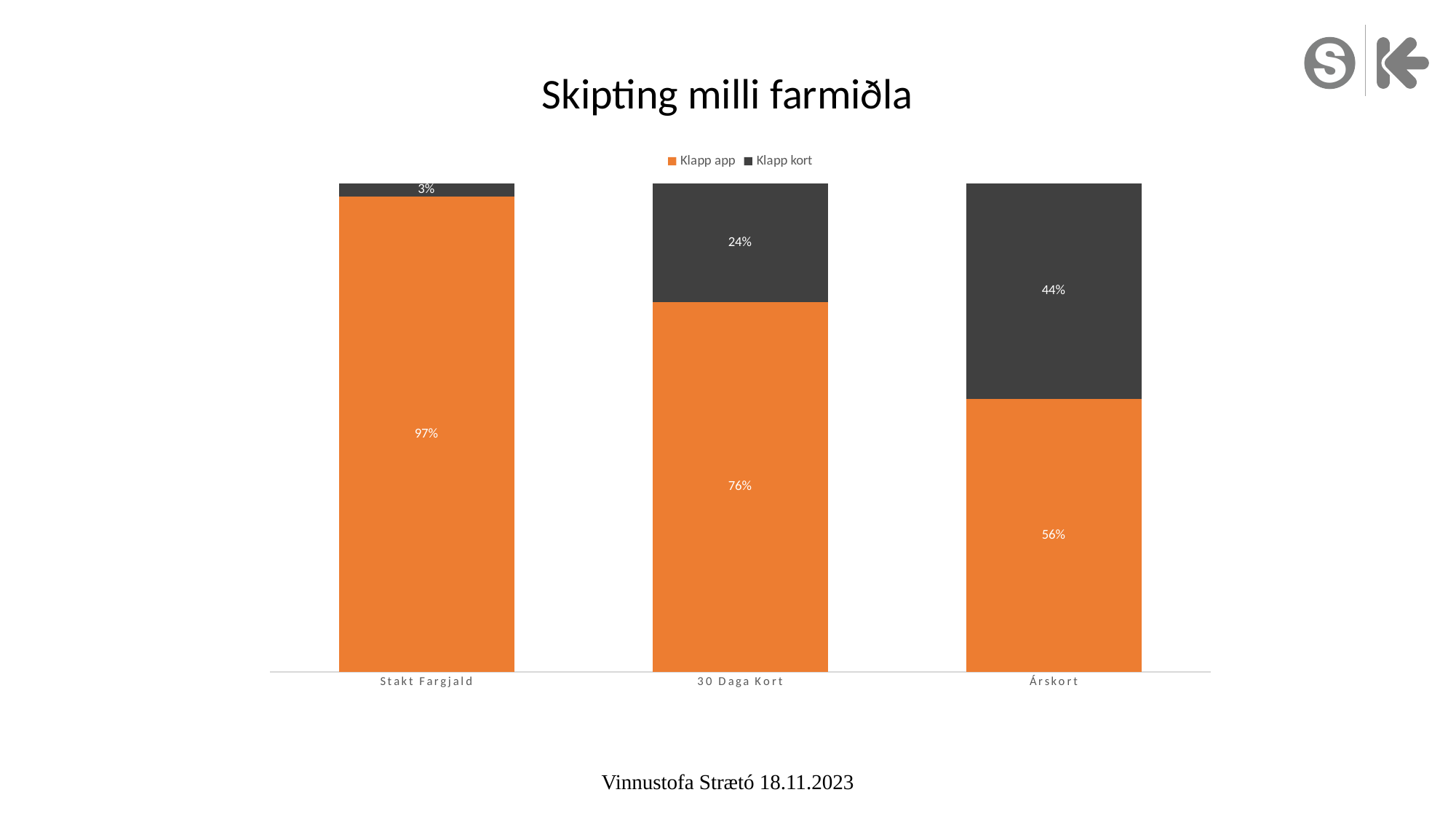
What is the difference between the Klapp app values for Stakt Fargjald and 30 Daga Kort? 21% How many categories are shown on the x axis? 3 What is the Klapp app value for Stakt Fargjald? 97% How many series does the legend list? 2 What is the title of the chart? Skipting milli farmiðla What kind of chart is shown? Stacked bar chart Which category has the highest Klapp kort share? Árskort Which is larger for Árskort, Klapp app or Klapp kort? Klapp app What is the Klapp kort value for 30 Daga Kort? 24% What is the Klapp app value for Árskort? 56% Which category has the lowest Klapp app share? Árskort What is the Klapp kort value for Stakt Fargjald? 3%